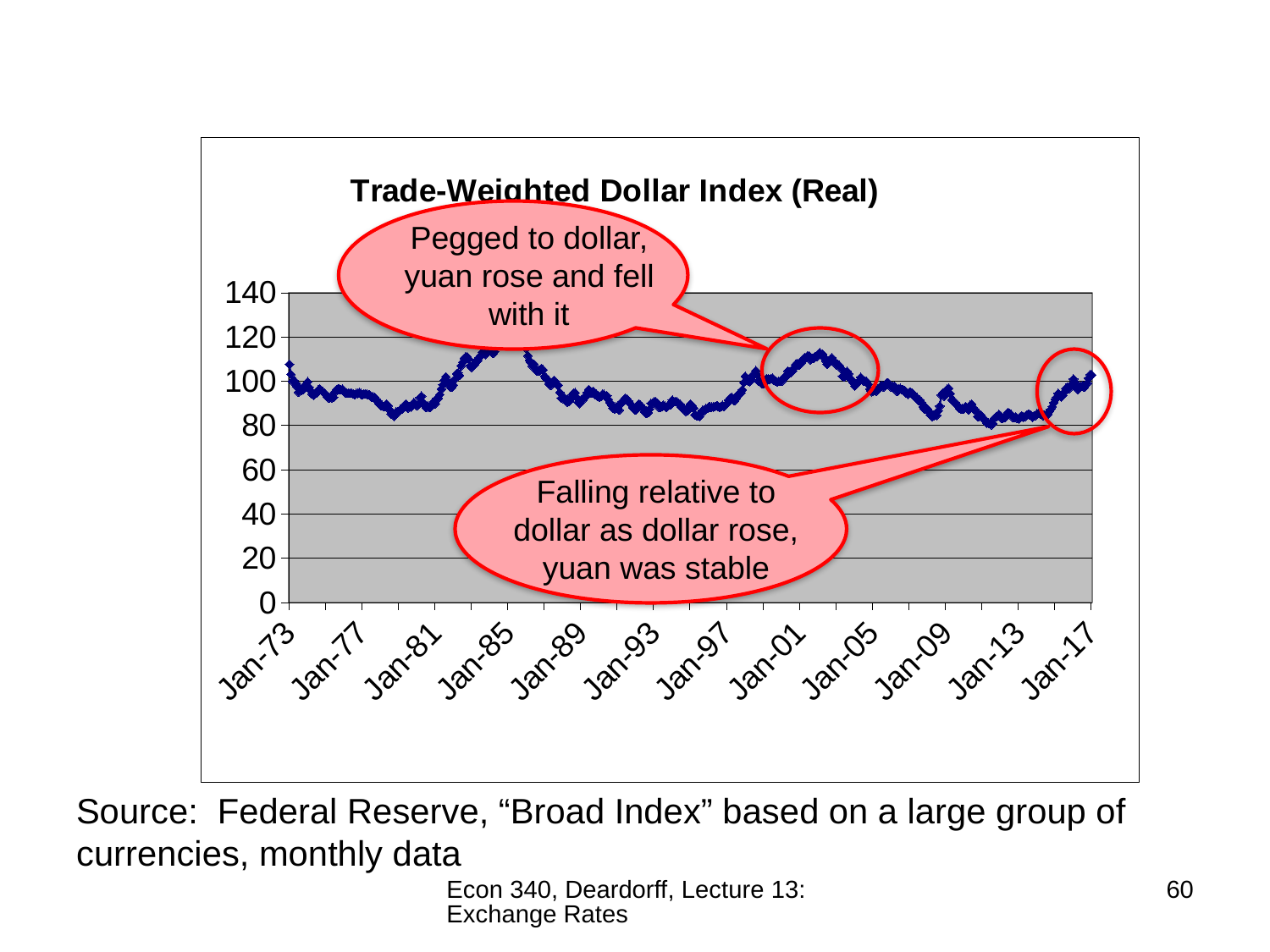
Is the value of the index at Jan-81 greater or less than 100? less Around which x-axis label does the index reach its highest value? Jan-85 Does the index rise or fall between Jan-13 and Jan-17? rise How many date labels are shown on the x axis? 12 Is the value of the index at Jan-01 greater or less than 100? greater Is the value of the index at Jan-13 greater or less than 100? less What is the title of the chart? Trade-Weighted Dollar Index (Real) What type of chart is shown on the slide? line chart Does the index rise or fall between Jan-85 and Jan-89? fall What is the highest value shown on the y axis? 140